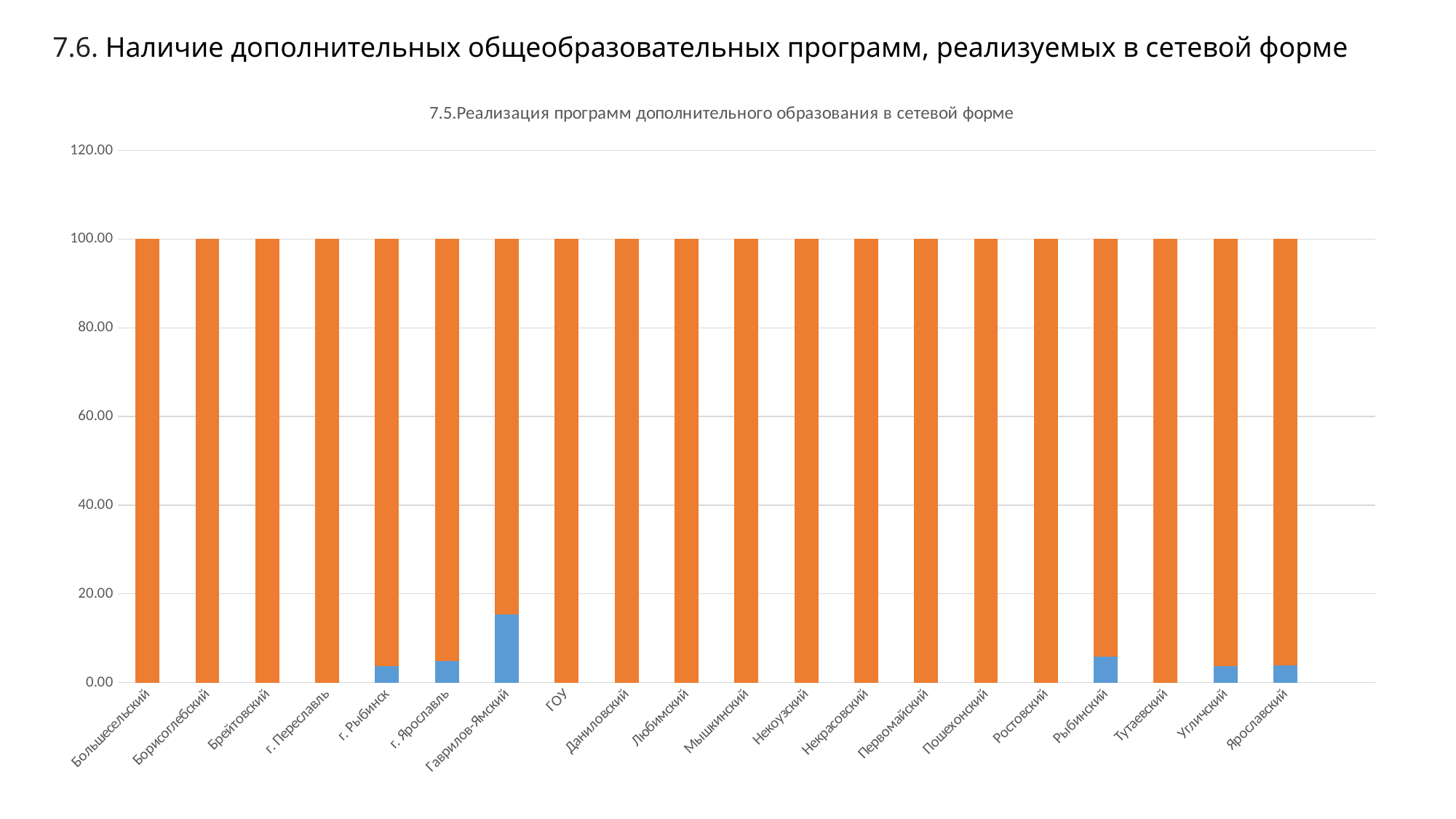
What kind of chart is shown on the slide? bar chart What is the highest value labelled on the vertical axis of the chart? 120.00 What is the total height of the stacked bar for Большесельский? 100.00 Is the blue segment for Гаврилов-Ямский greater or less than 20? less How many categories are shown along the x axis of the chart? 20 How many bars in the chart have a visible blue segment? 6 Which has the larger blue segment, г. Ярославль or Гаврилов-Ямский? Гаврилов-Ямский Which category has the largest blue segment in its bar? Гаврилов-Ямский Is the total height of the bar for Тутаевский greater or less than 80? greater What is the total height of the stacked bar for Ростовский? 100.00 What is the title of the chart? 7.5.Реализация программ дополнительного образования в сетевой форме Which has the larger blue segment, Гаврилов-Ямский or Рыбинский? Гаврилов-Ямский